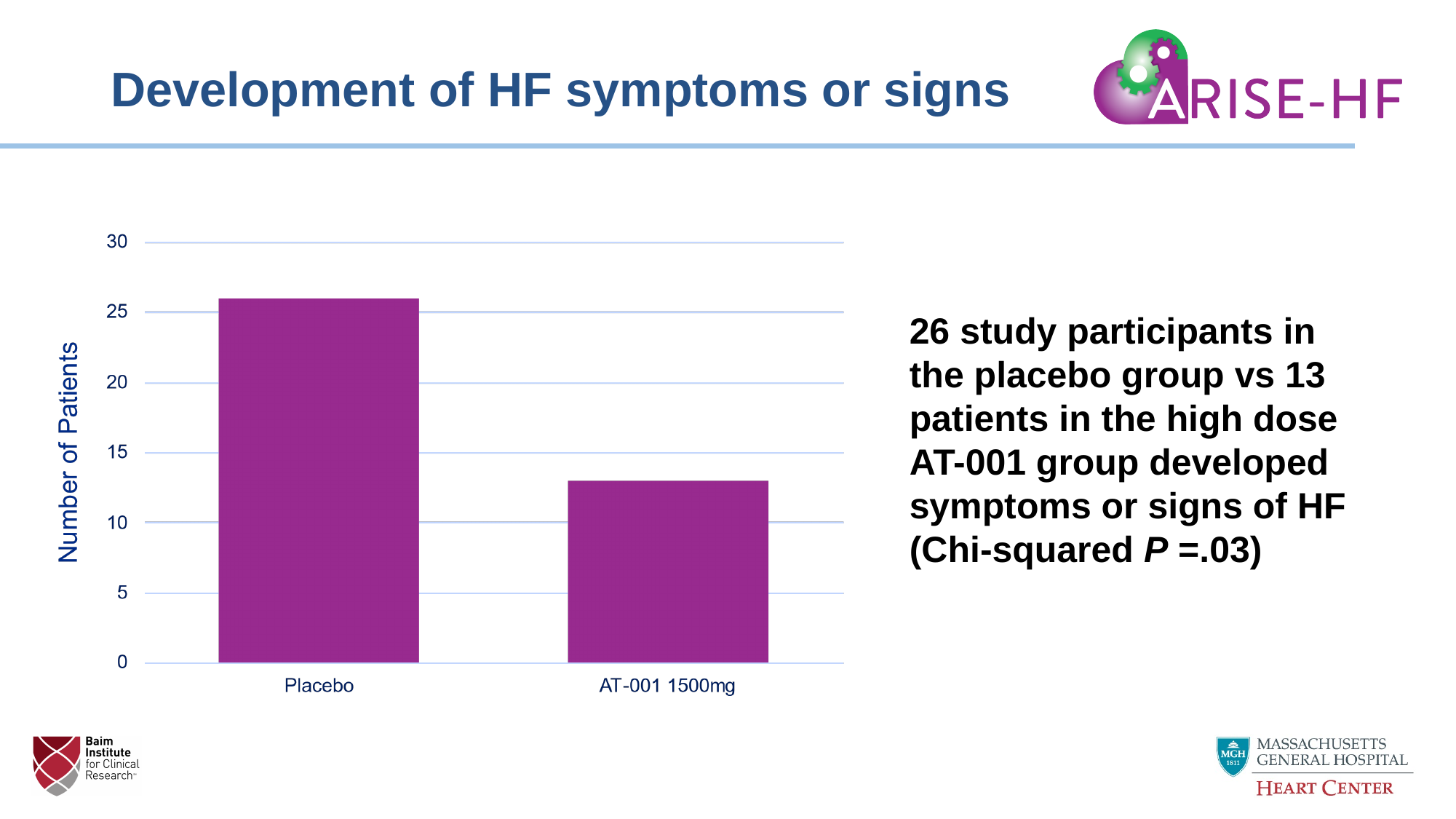
What is the difference in number of patients between the Placebo and AT-001 1500mg groups? 13 Is the value for Placebo greater or less than 25? greater What is the title of the slide containing the chart? Development of HF symptoms or signs How many patients in the placebo group developed HF symptoms or signs? 26 Which group has the higher number of patients in the chart? Placebo How many patients in the AT-001 1500mg group developed HF symptoms or signs? 13 Is the number of patients for Placebo larger or smaller than for AT-001 1500mg? larger What type of chart is shown on the slide? bar chart Is the value for AT-001 1500mg greater or less than 15? less What is the label of the y axis of the chart? Number of Patients How many categories are shown on the x axis of the chart? 2 Which group has the lower number of patients in the chart? AT-001 1500mg